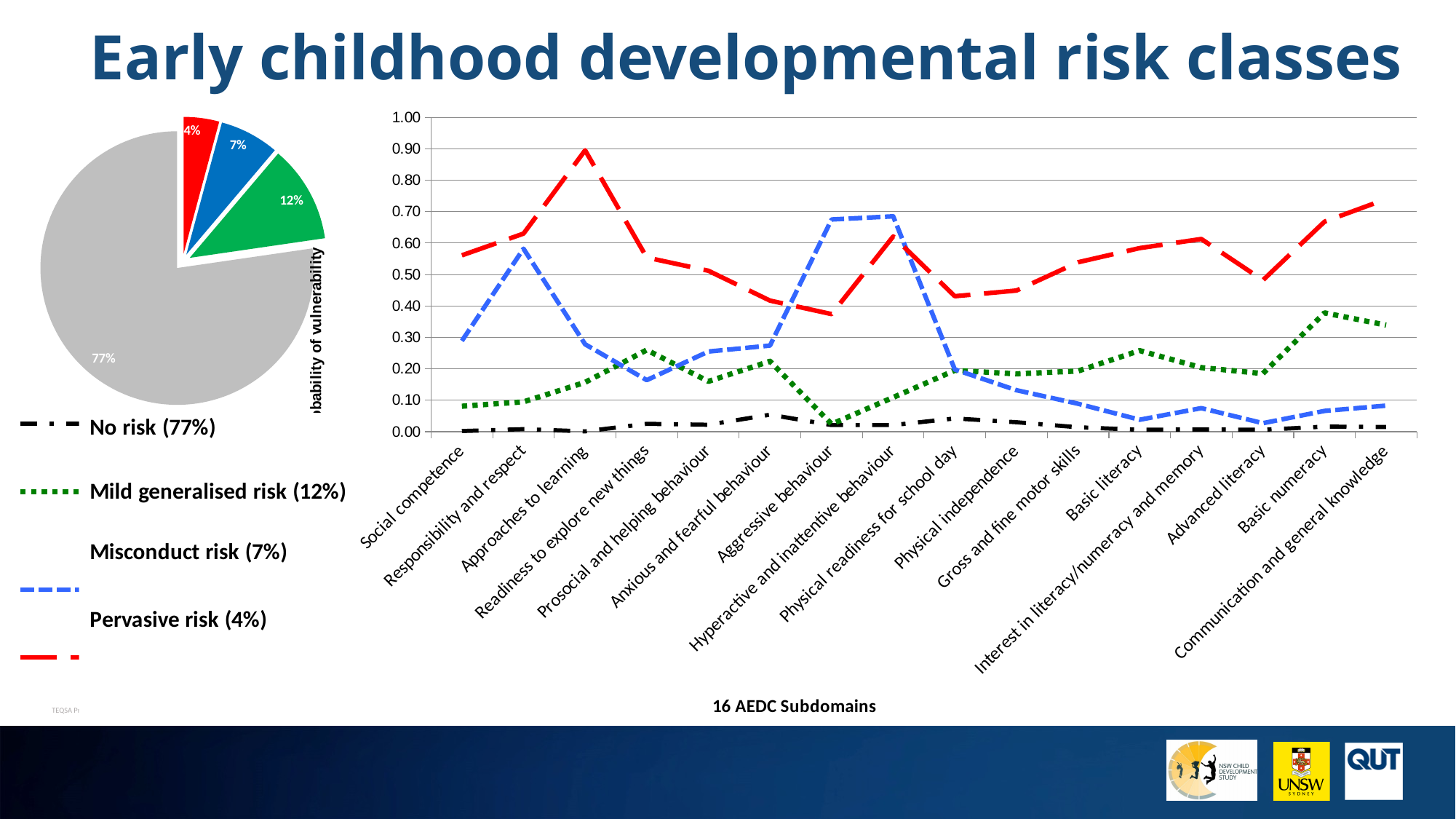
In the line chart, at Aggressive behaviour, which is larger: Misconduct risk or Pervasive risk? Misconduct risk What is the x-axis title of the line chart? 16 AEDC Subdomains In the line chart, is the value for Pervasive risk at Approaches to learning greater or less than 0.80? greater In the pie chart, what percentage is shown for the No risk class? 77% In the line chart, is the value for Misconduct risk at Aggressive behaviour greater or less than 0.60? greater In the line chart, which risk class has the highest probability of vulnerability at Approaches to learning? Pervasive risk In the pie chart, which risk class has the largest slice? No risk (77%) How many subdomains are plotted along the x axis of the line chart? 16 In the pie chart, which risk class has the smallest slice? Pervasive risk (4%) In the pie chart, what is the difference in percentage points between Mild generalised risk and Misconduct risk? 5 percentage points What kind of chart is the chart on the right of the slide? Line chart How many slices does the pie chart have? 4